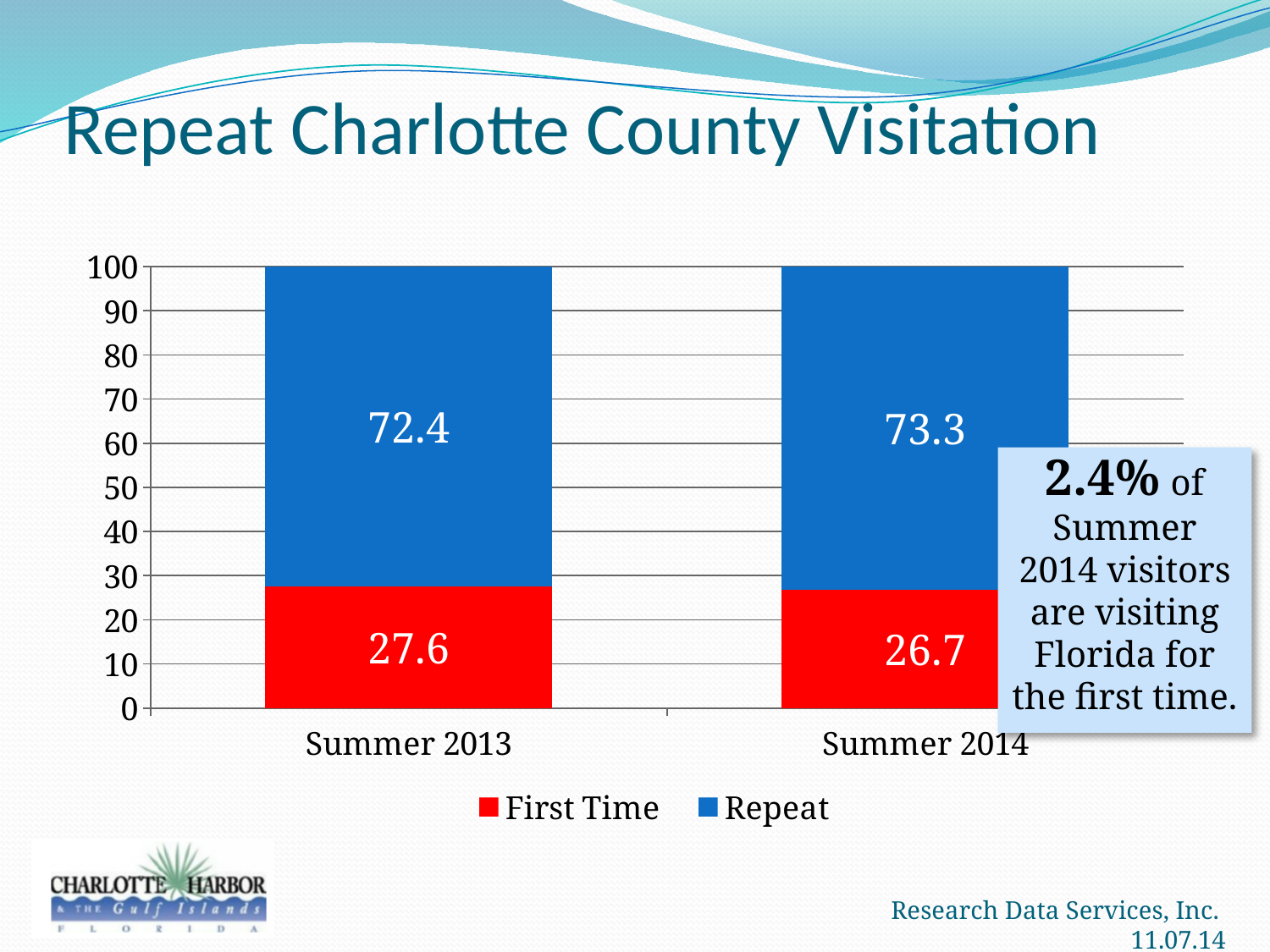
How many series does the legend list? 2 What is the total of the stacked bar for Summer 2013? 100 What is the difference between the Repeat values for Summer 2014 and Summer 2013? 0.9 How many categories are shown on the x axis? 2 Which period has the lower First Time value? Summer 2014 Which period has the higher Repeat value, Summer 2013 or Summer 2014? Summer 2014 What is the difference between the First Time values for Summer 2013 and Summer 2014? 0.9 What is the Repeat value for Summer 2013? 72.4 What is the First Time value for Summer 2014? 26.7 What is the First Time value for Summer 2013? 27.6 What is the Repeat value for Summer 2014? 73.3 What kind of chart is shown on the slide? Stacked bar chart